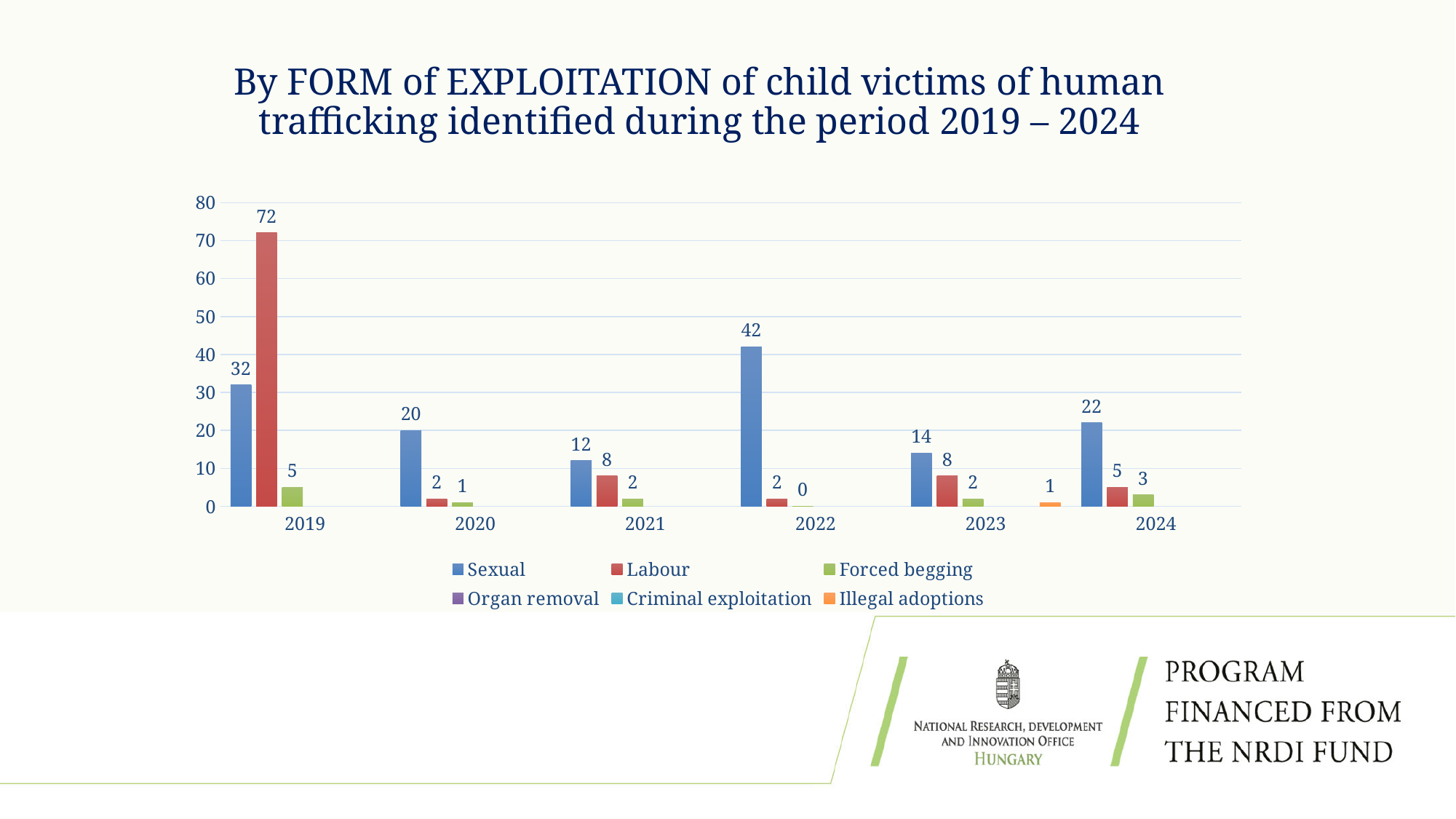
What is the value for Labour in 2019? 72 Which colour represents the Labour series? Red What is the value for Illegal adoptions in 2023? 1 What kind of chart is shown on the slide? Bar chart In which year is the Sexual exploitation value highest? 2022 How many years are shown on the x axis? 6 Which is larger in 2021, Sexual or Labour? Sexual How many series does the legend list? 6 What is the difference between the Labour and Sexual values in 2019? 40 In which year is the Sexual exploitation value lowest? 2021 What is the value for Sexual exploitation in 2022? 42 What is the value for Forced begging in 2024? 3